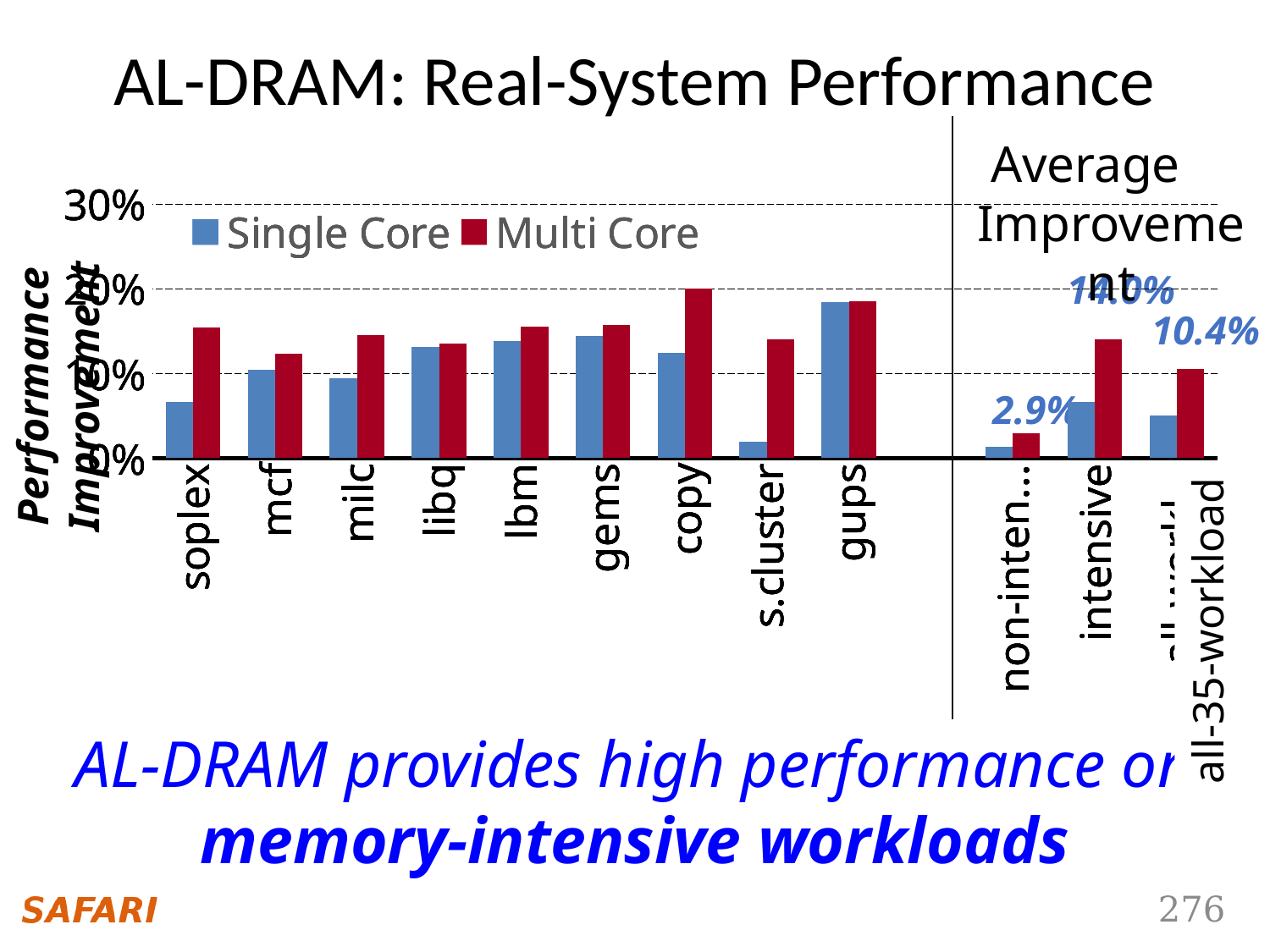
Is the Single Core value for soplex greater or less than 10%? less What kind of chart is shown on the slide? bar chart Is the Multi Core value for copy greater or less than 10%? greater Which category has the highest Multi Core performance improvement? copy Among the nine benchmarks left of the divider, which has the lowest Single Core performance improvement? s.cluster Which category has the highest Single Core performance improvement? gups For soplex, which series has the larger value, Single Core or Multi Core? Multi Core How many series does the chart legend list? 2 How many workload categories are plotted to the left of the vertical divider line? 9 What are the two series named in the chart legend? Single Core and Multi Core What Multi Core average improvement is labelled for all-35-workload? 10.4% Is the Single Core value for s.cluster greater or less than 10%? less